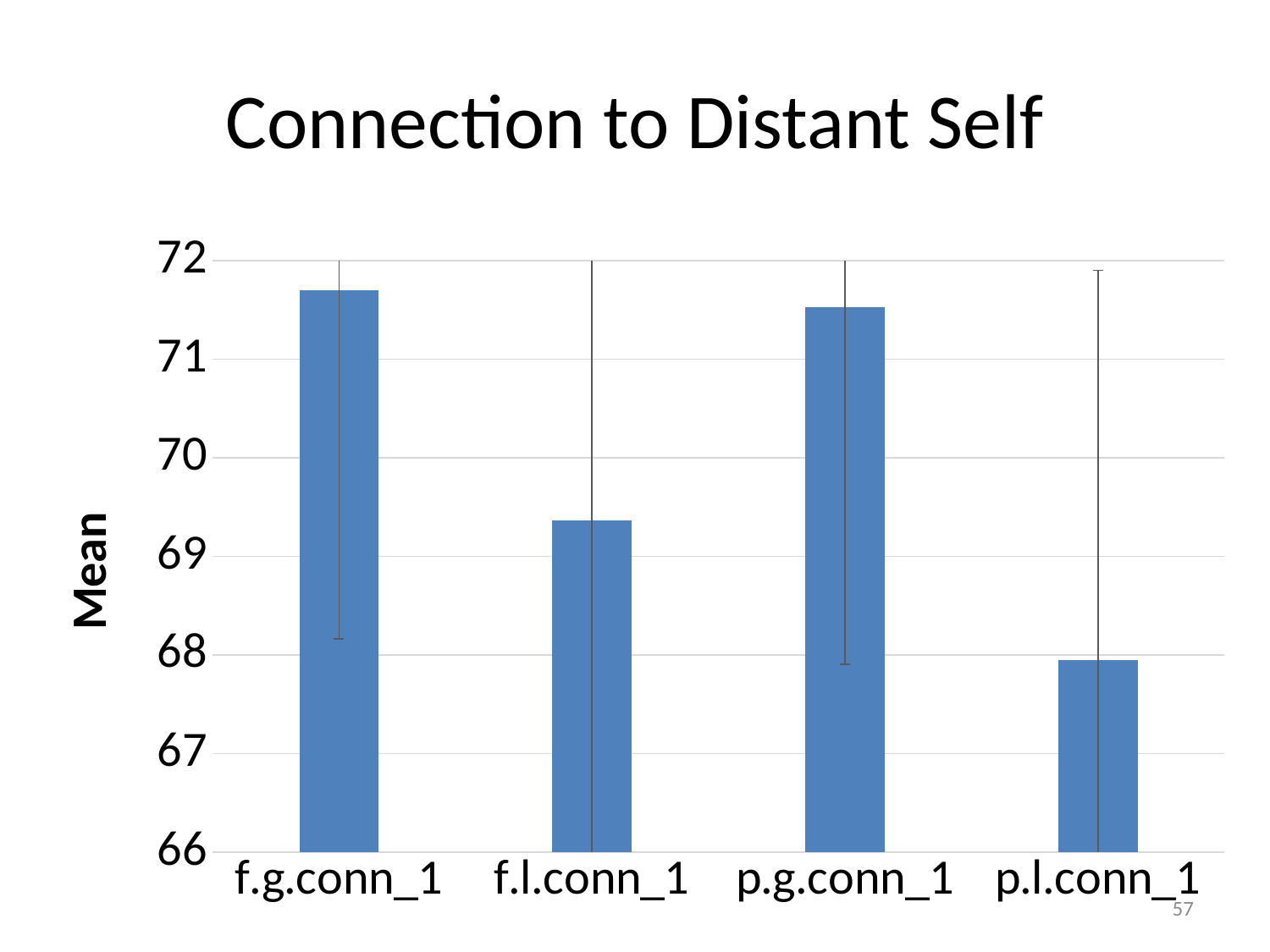
What kind of chart is shown on the slide? bar chart What is the title of the chart? Connection to Distant Self What is the label on the vertical axis? Mean Is the value for f.g.conn_1 greater or less than 71? greater Is the value for f.l.conn_1 greater or less than 70? less Which category has the lowest mean? p.l.conn_1 Is the value for p.g.conn_1 greater or less than 71? greater How many categories are plotted on the chart? 4 Which is larger, the value for p.g.conn_1 or p.l.conn_1? p.g.conn_1 Which is larger, the value for f.g.conn_1 or f.l.conn_1? f.g.conn_1